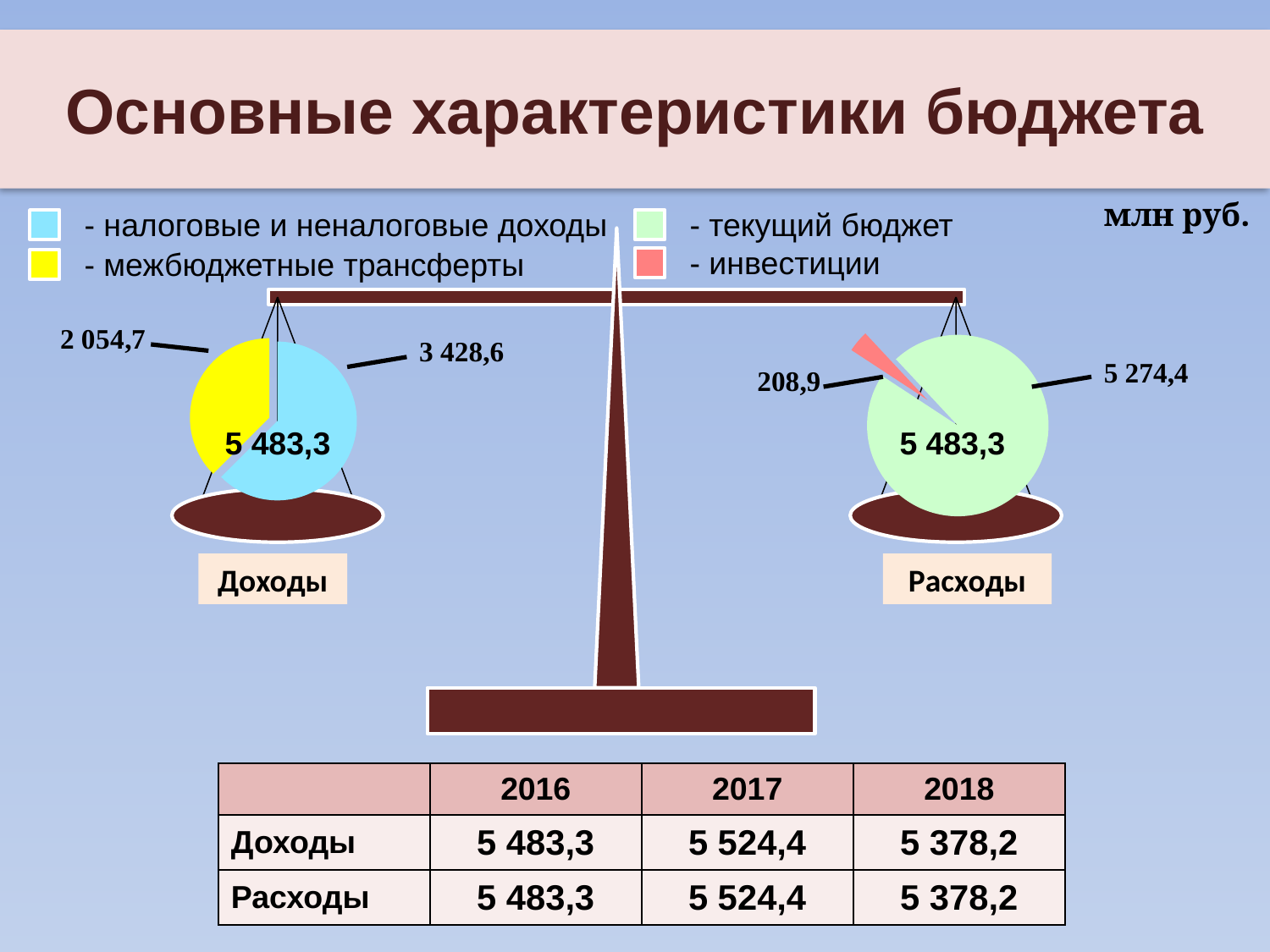
In the Расходы (right) pie chart, what is the difference between текущий бюджет and инвестиции? 5 065,5 In the Расходы (right) pie chart, what is the value for текущий бюджет? 5 274,4 In the Доходы (left) pie chart, which slice is the largest? налоговые и неналоговые доходы In the Доходы (left) pie chart, what is the difference between налоговые и неналоговые доходы and межбюджетные трансферты? 1 373,9 How many slices does the Доходы (left) pie chart have? 2 In the Доходы (left) pie chart, what is the value for межбюджетные трансферты? 2 054,7 In the Расходы (right) pie chart, which slice is the smallest? инвестиции What colour is the инвестиции slice in the Расходы (right) pie chart? red (pink) In the Доходы (left) pie chart, what is the value for налоговые и неналоговые доходы? 3 428,6 In the Расходы (right) pie chart, what is the value for инвестиции? 208,9 What is the total shown in the centre of the Расходы (right) pie chart? 5 483,3 What kind of chart is used for the Доходы (left) chart? pie chart